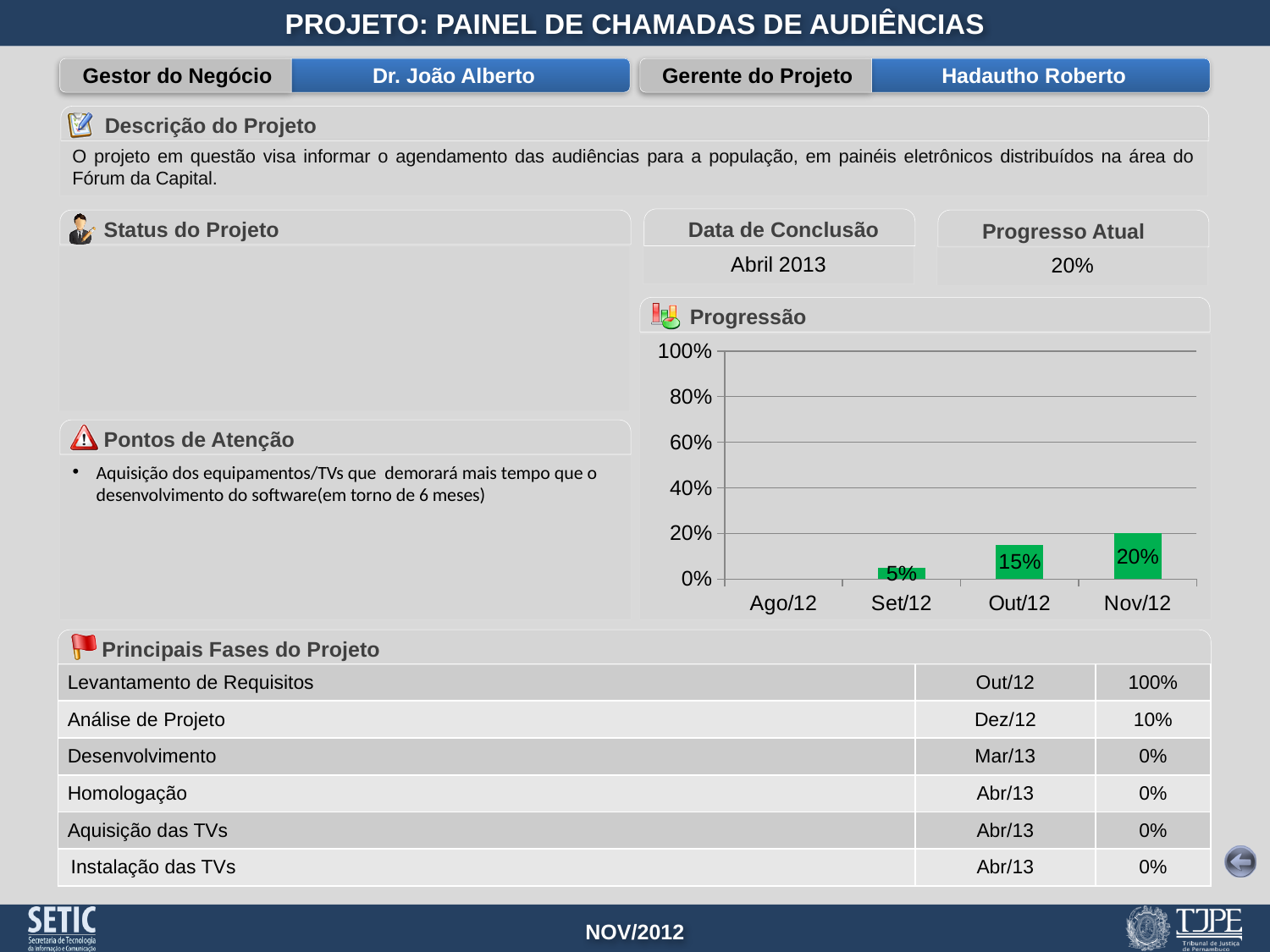
What is the value for Out/12 in the Progressão chart? 15% What kind of chart is the Progressão chart? bar chart How many months are shown on the x axis of the Progressão chart? 4 What is the value for Nov/12 in the Progressão chart? 20% What is the difference between the values for Nov/12 and Set/12 in the Progressão chart? 15% In the Progressão chart, which is larger: the value for Out/12 or the value for Set/12? Out/12 Do the values in the Progressão chart rise or fall from Set/12 to Nov/12? rise What is the difference between the values for Out/12 and Set/12 in the Progressão chart? 10% In the Progressão chart, is the value for Nov/12 greater or less than 40%? less What is the value for Set/12 in the Progressão chart? 5% What colour are the bars in the Progressão chart? green Which month has the highest value in the Progressão chart? Nov/12